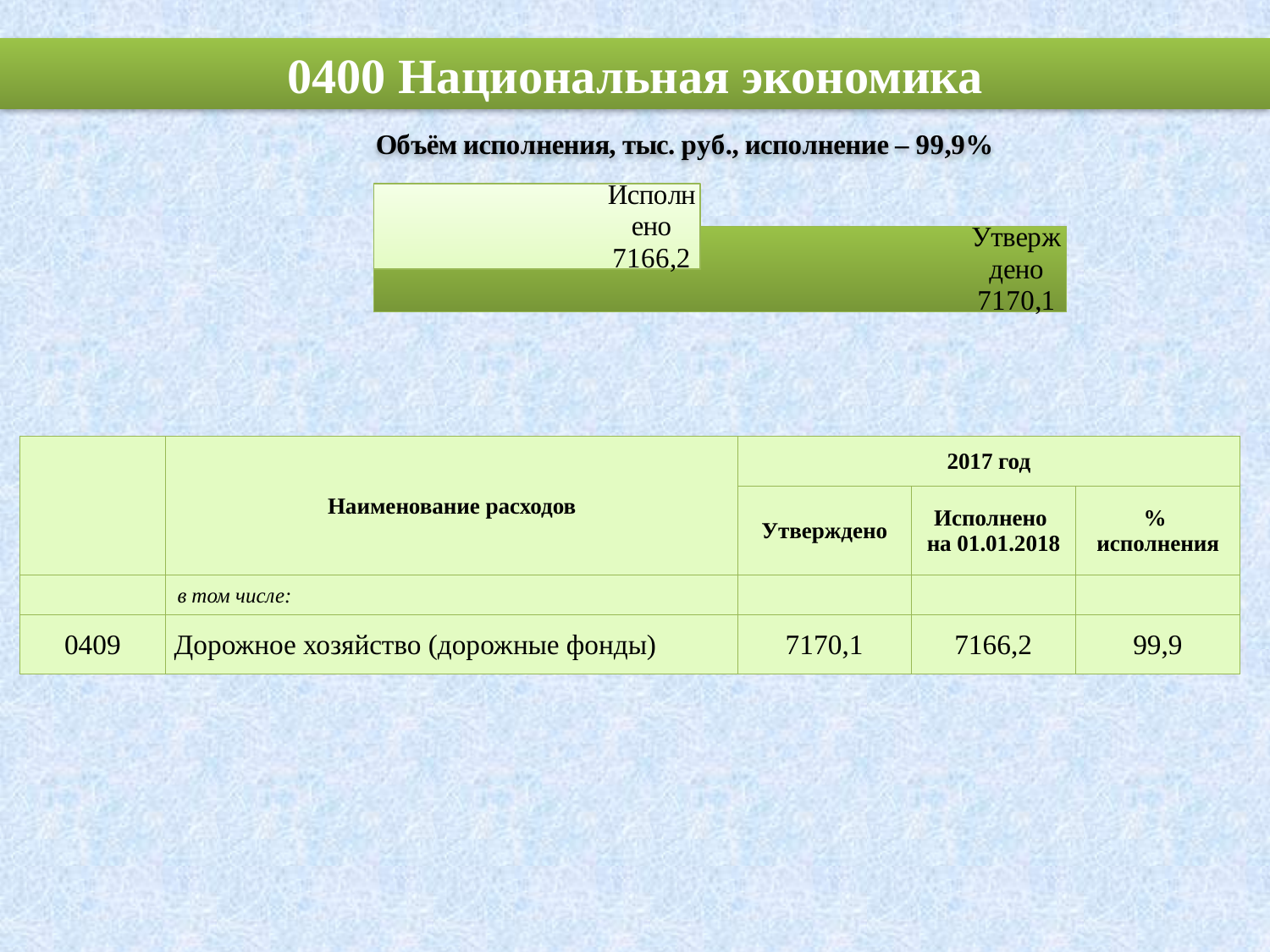
How many bars are plotted in the chart? 2 What is the difference between the "Утверждено" and "Исполнено" values in the chart? 3,9 Which bar in the chart has the lowest value? Исполнено What unit of measurement does the chart title state for the values? тыс. руб. What is the value of the bar labelled "Утверждено" in the chart? 7170,1 Is the "Исполнено" value in the chart larger or smaller than the "Утверждено" value? smaller What is the title of the chart on the slide? Объём исполнения, тыс. руб., исполнение – 99,9% What type of chart is shown on the slide? bar chart What is the value of the bar labelled "Исполнено" in the chart? 7166,2 Which bar in the chart has the higher value, "Утверждено" or "Исполнено"? Утверждено What execution percentage is stated in the chart title? 99,9%